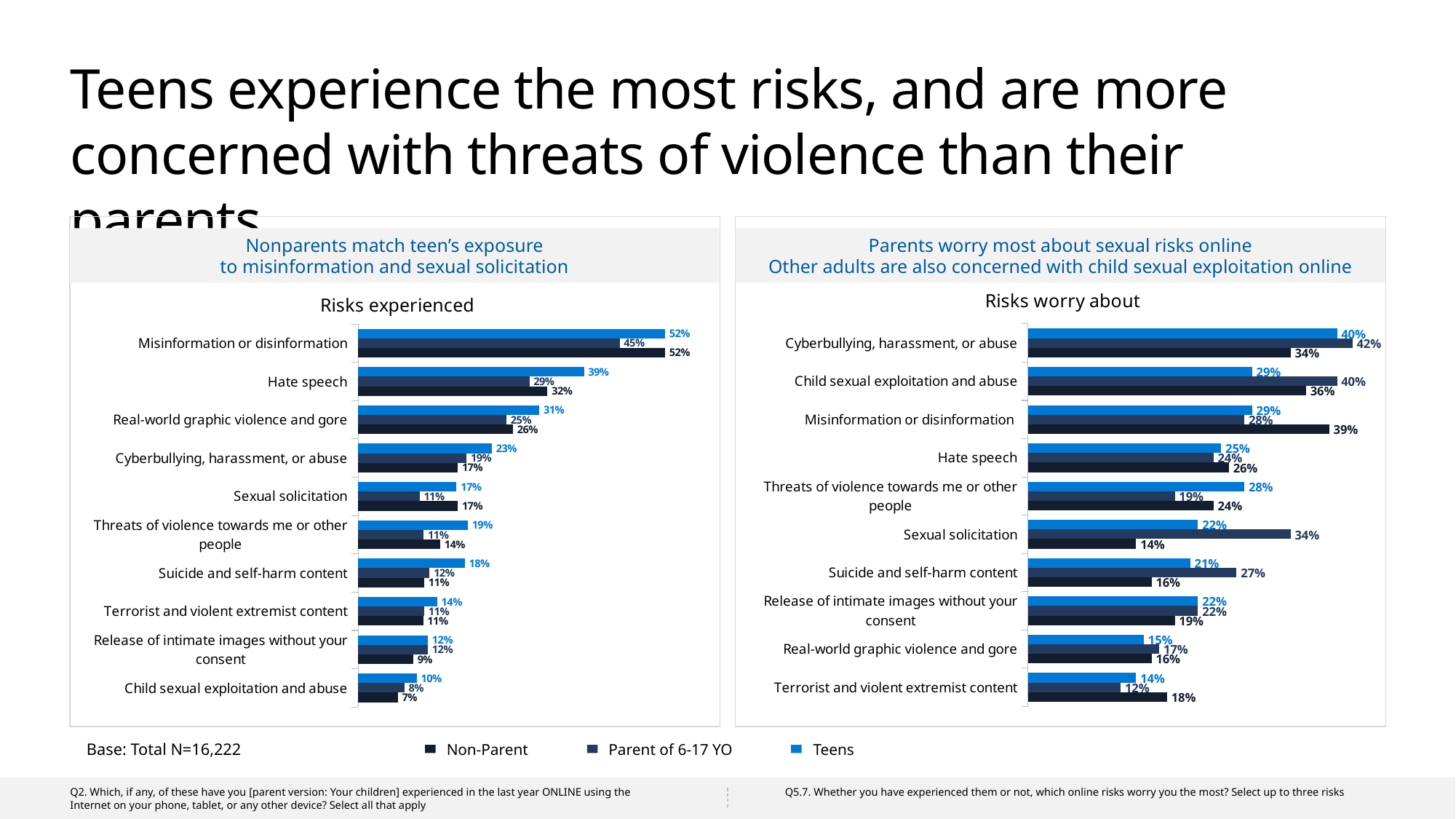
In the 'Risks worry about' chart, what percentage of Non-Parents worry about misinformation or disinformation? 39% How many series does the legend list? 3 In the 'Risks worry about' chart, which risk has the highest value for Parent of 6-17 YO? Cyberbullying, harassment, or abuse In the 'Risks experienced' chart, what is the difference between the Teens and Non-Parent values for hate speech? 7% In the 'Risks worry about' chart, what is the difference between the Parent of 6-17 YO and Non-Parent values for sexual solicitation? 20% In the 'Risks worry about' chart, which is larger for child sexual exploitation and abuse: the Teens value or the Parent of 6-17 YO value? Parent of 6-17 YO In the 'Risks experienced' chart, what is the value for Parent of 6-17 YO for misinformation or disinformation? 45% In the 'Risks experienced' chart, which risk has the lowest value for Teens? Child sexual exploitation and abuse In the 'Risks experienced' chart, what percentage of Teens experienced hate speech? 39% What type of chart is the 'Risks worry about' chart? Bar chart In the 'Risks worry about' chart, what is the Parent of 6-17 YO value for sexual solicitation? 34% How many risk categories are shown in the 'Risks experienced' chart? 10